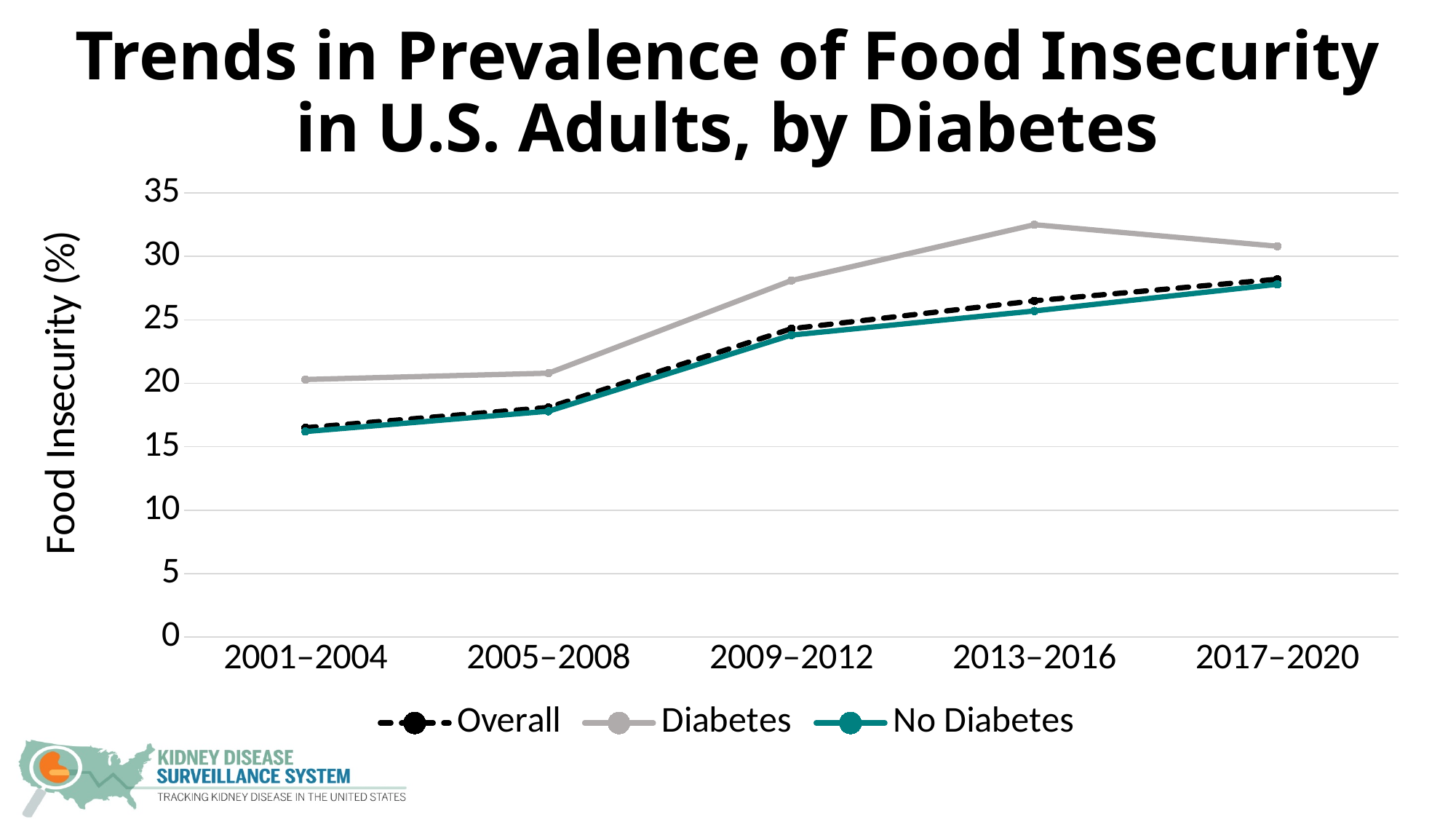
In which period is the No Diabetes series at its lowest value? 2001–2004 Is the value for No Diabetes in 2017–2020 greater or less than 30? less In 2013–2016, which series has the larger value, Diabetes or No Diabetes? Diabetes How many time periods are shown on the x axis? 5 How many series does the legend list? 3 Is the value for Overall in 2009–2012 greater or less than 25? less Is the value for Diabetes in 2013–2016 greater or less than 30? greater Does the No Diabetes series rise or fall from 2001–2004 to 2017–2020? Rises What kind of chart is shown on the slide? Line chart Which series is listed first in the legend? Overall What is the label of the y axis? Food Insecurity (%) In which period does the Diabetes series reach its highest value? 2013–2016